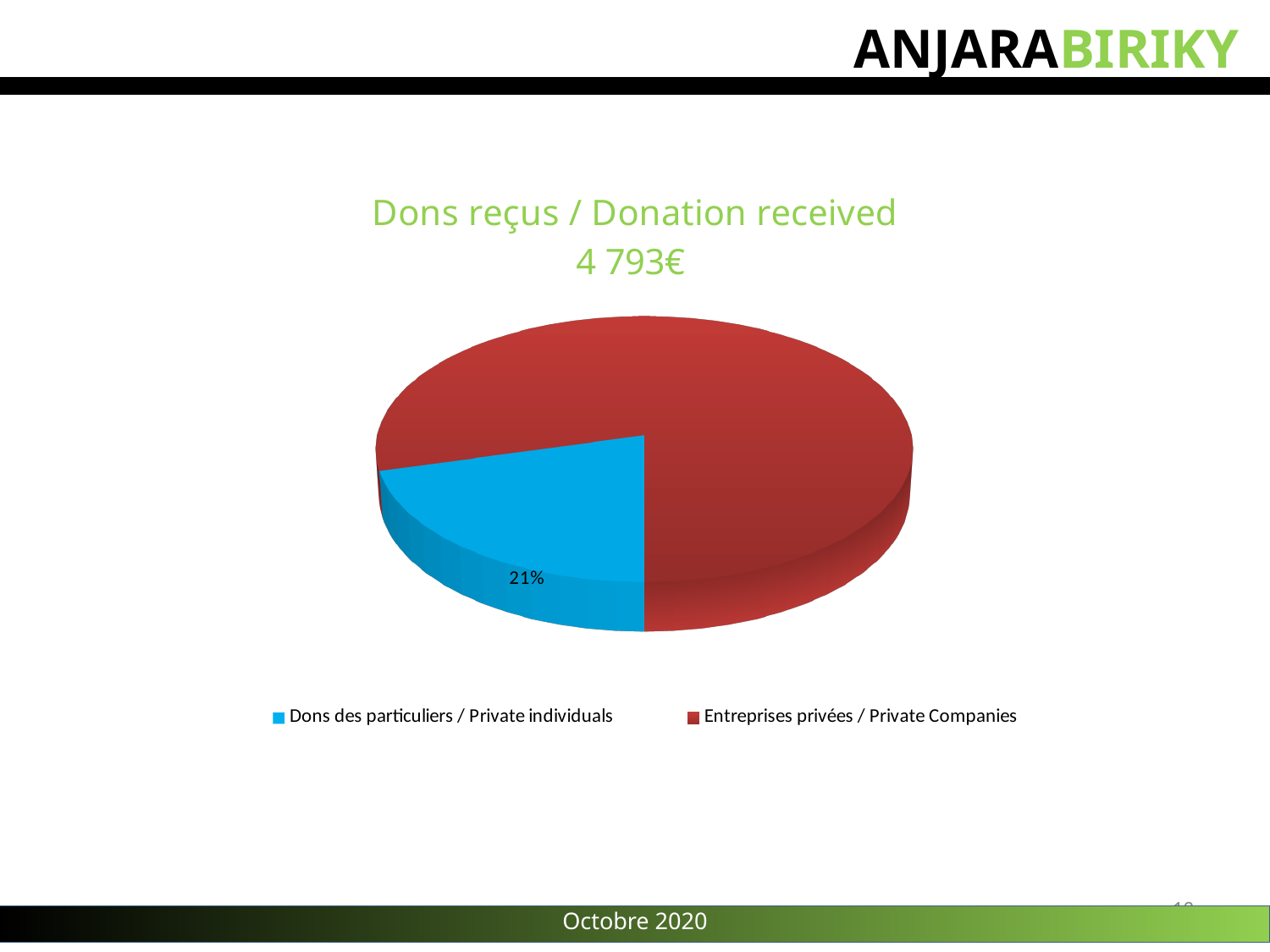
How many slices does the pie chart have? 2 What is the title of the chart? Dons reçus / Donation received 4 793€ What colour is the slice for Dons des particuliers / Private individuals? blue Which category has the smallest slice of the pie? Dons des particuliers / Private individuals What share of the pie is labelled for Dons des particuliers / Private individuals? 21% Which category has the largest slice of the pie? Entreprises privées / Private Companies Which is larger: the slice for Private individuals or the slice for Private Companies? Private Companies How many entries does the legend list? 2 What kind of chart is shown on the slide? pie chart